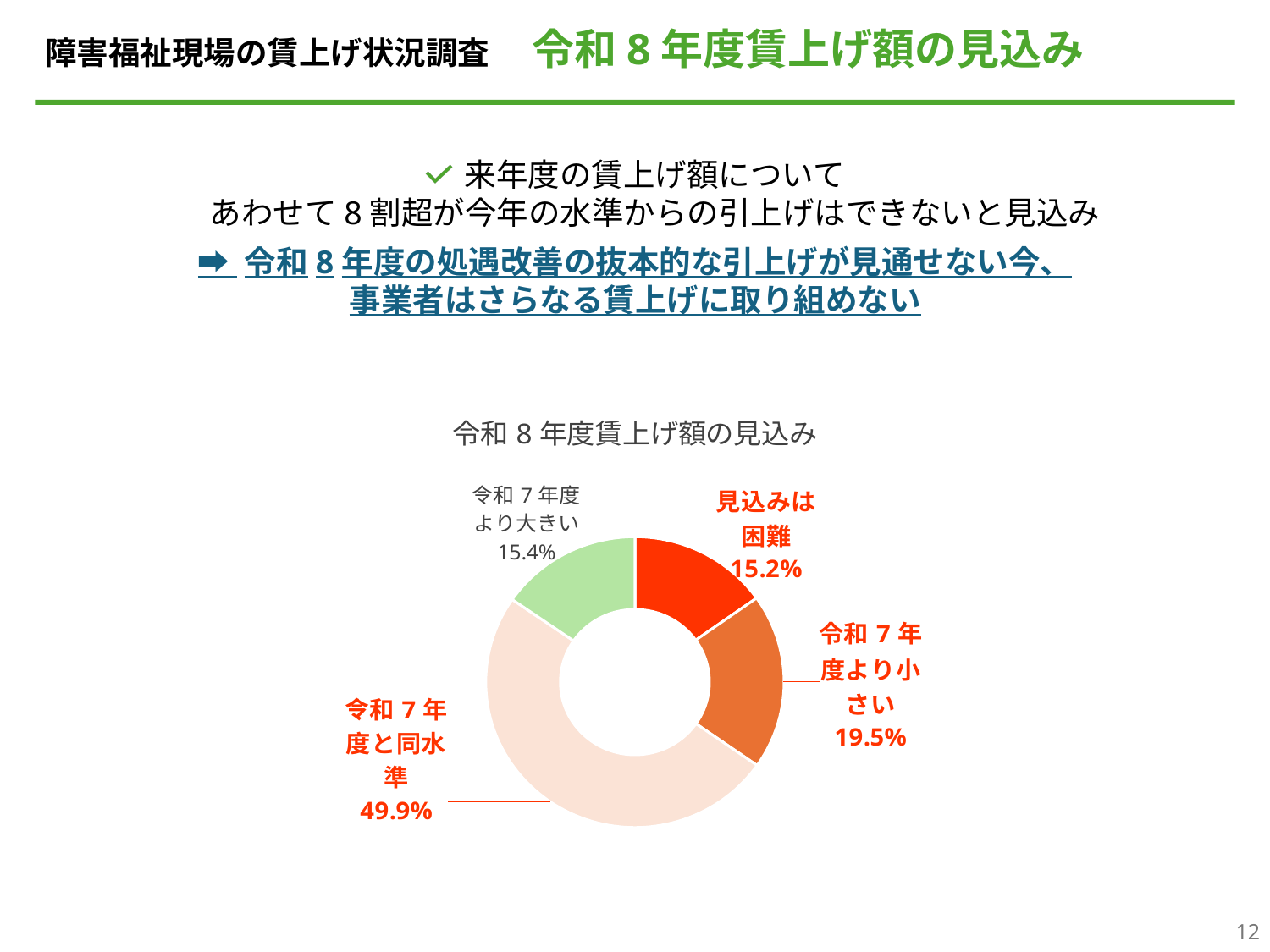
What kind of chart is shown on the slide? Pie (donut) chart What is the title of the chart? 令和8年度賃上げ額の見込み What is the combined share of 令和7年度と同水準, 令和7年度より小さい and 見込みは困難? 84.6% What is the value for 令和7年度より小さい? 19.5% What is the value for 令和7年度より大きい? 15.4% What is the value for 見込みは困難? 15.2% Which category has the largest share of the chart? 令和7年度と同水準 What is the difference between the shares of 令和7年度と同水準 and 令和7年度より小さい? 30.4% What share of the pie does 令和7年度と同水準 represent? 49.9% Which category has the smallest share of the chart? 見込みは困難 How many categories are shown in the chart? 4 Which is larger, the share for 令和7年度より小さい or the share for 令和7年度より大きい? 令和7年度より小さい